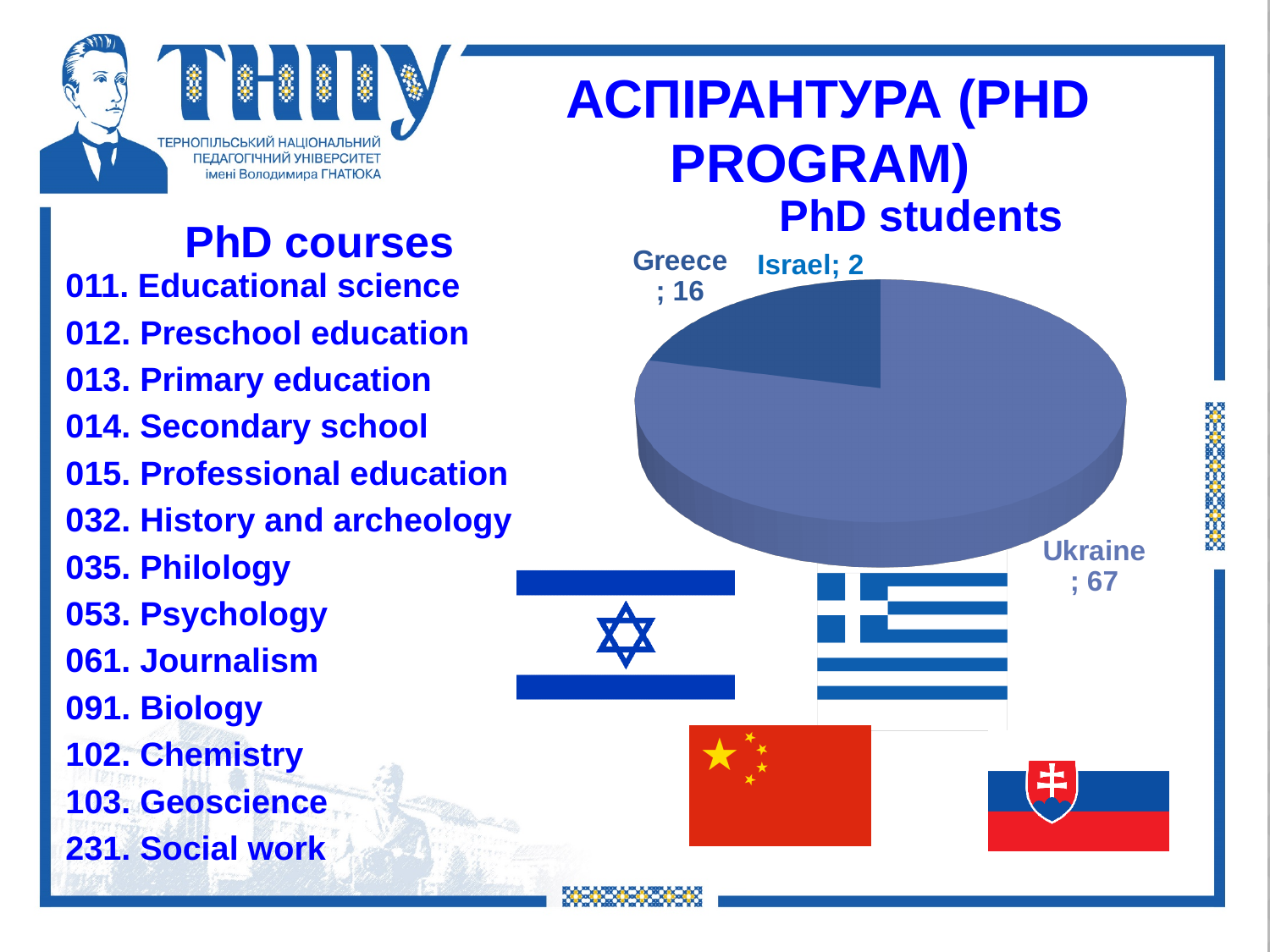
How many PhD students are from Ukraine? 67 Which has more PhD students, Greece or Israel? Greece What is the title of the chart? PhD students How many PhD students are from Greece? 16 What is the total number of PhD students shown in the pie chart? 85 What kind of chart is used to show the PhD students? pie chart Which country has the smallest slice of the PhD students pie? Israel Which country has the largest slice of the PhD students pie? Ukraine How many PhD students are from Israel? 2 How many more PhD students are from Ukraine than from Greece? 51 How many more PhD students are from Greece than from Israel? 14 How many countries are shown in the PhD students pie chart? 3